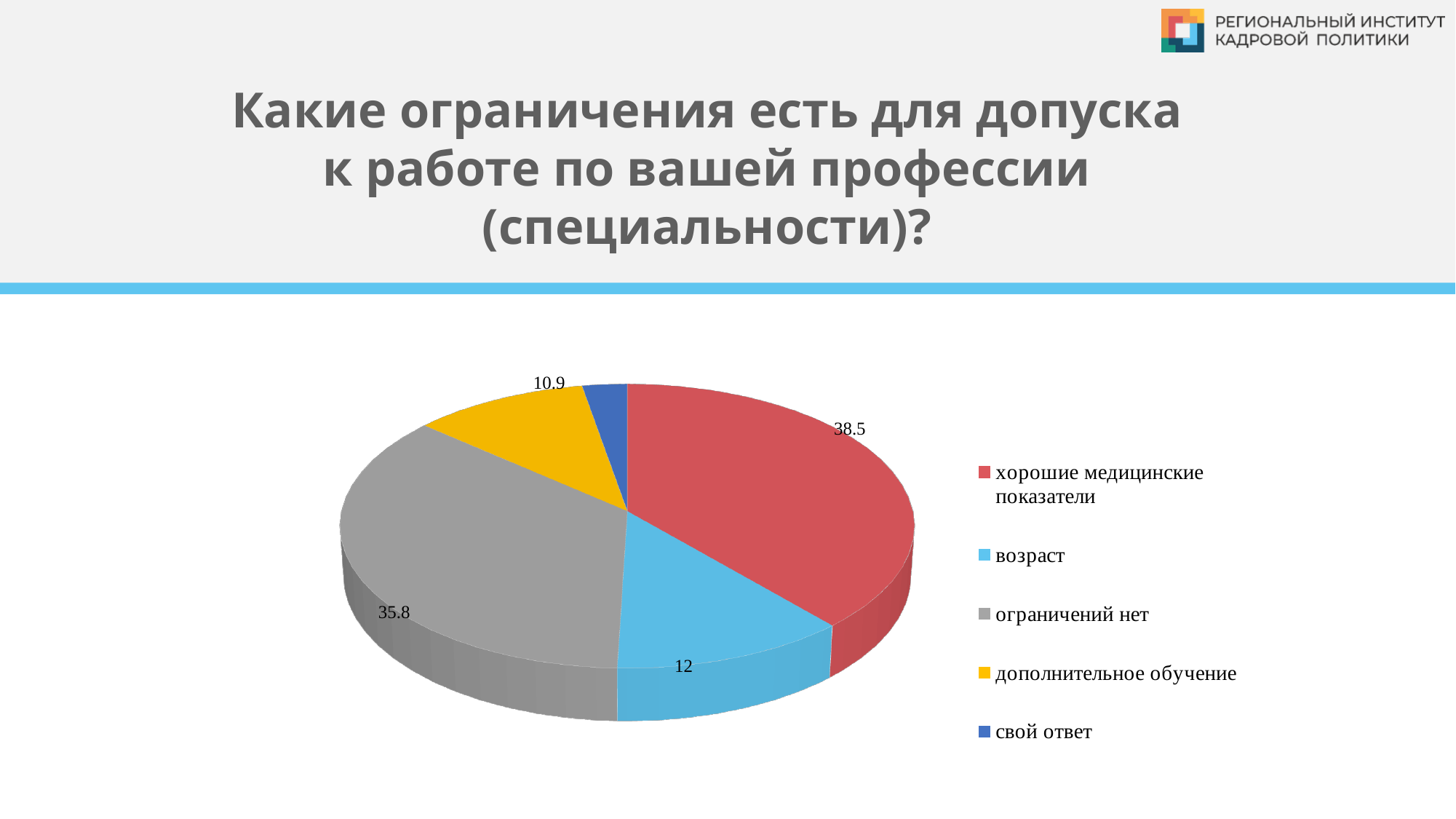
Which category has the largest slice of the pie? хорошие медицинские показатели What is the value for "возраст"? 12 What is the value for "дополнительное обучение"? 10.9 What is the value for "ограничений нет"? 35.8 How many categories does the legend list? 5 What is the difference between the values for "возраст" and "дополнительное обучение"? 1.1 What is the value for "хорошие медицинские показатели"? 38.5 Which category has the smallest slice of the pie? свой ответ What colour is the slice for "ограничений нет"? grey What is the difference between the values for "хорошие медицинские показатели" and "ограничений нет"? 2.7 Which is larger, the value for "возраст" or the value for "дополнительное обучение"? возраст What kind of chart is shown on the slide? pie chart